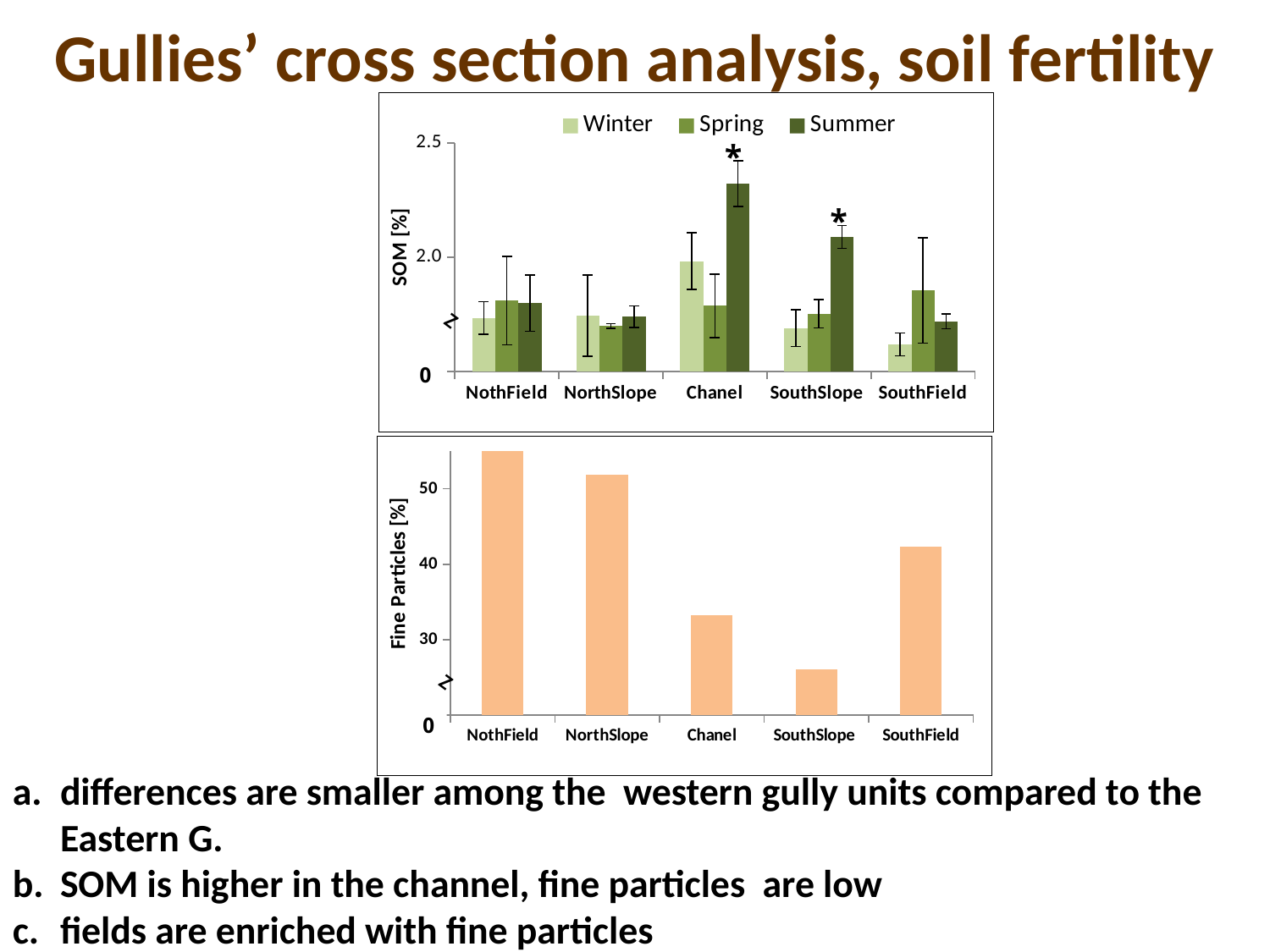
In the top chart (SOM [%]), which category has the tallest bar? Chanel In the bottom chart (Fine Particles [%]), is the value for SouthSlope greater or less than 30? less In the top chart (SOM [%]), is the Summer value for Chanel greater or less than 2.0? greater What kind of chart is the bottom chart (Fine Particles [%])? bar chart In the bottom chart (Fine Particles [%]), which category has the lowest value? SouthSlope In the bottom chart (Fine Particles [%]), which category has the highest value? NothField In the bottom chart (Fine Particles [%]), is the value for NothField greater or less than 50? greater In the top chart (SOM [%]), what are the legend entries? Winter, Spring, Summer In the top chart (SOM [%]), how many categories are shown on the x axis? 5 In the top chart (SOM [%]), how many series does the legend list? 3 In the bottom chart (Fine Particles [%]), which is larger, the value for Chanel or the value for SouthField? SouthField